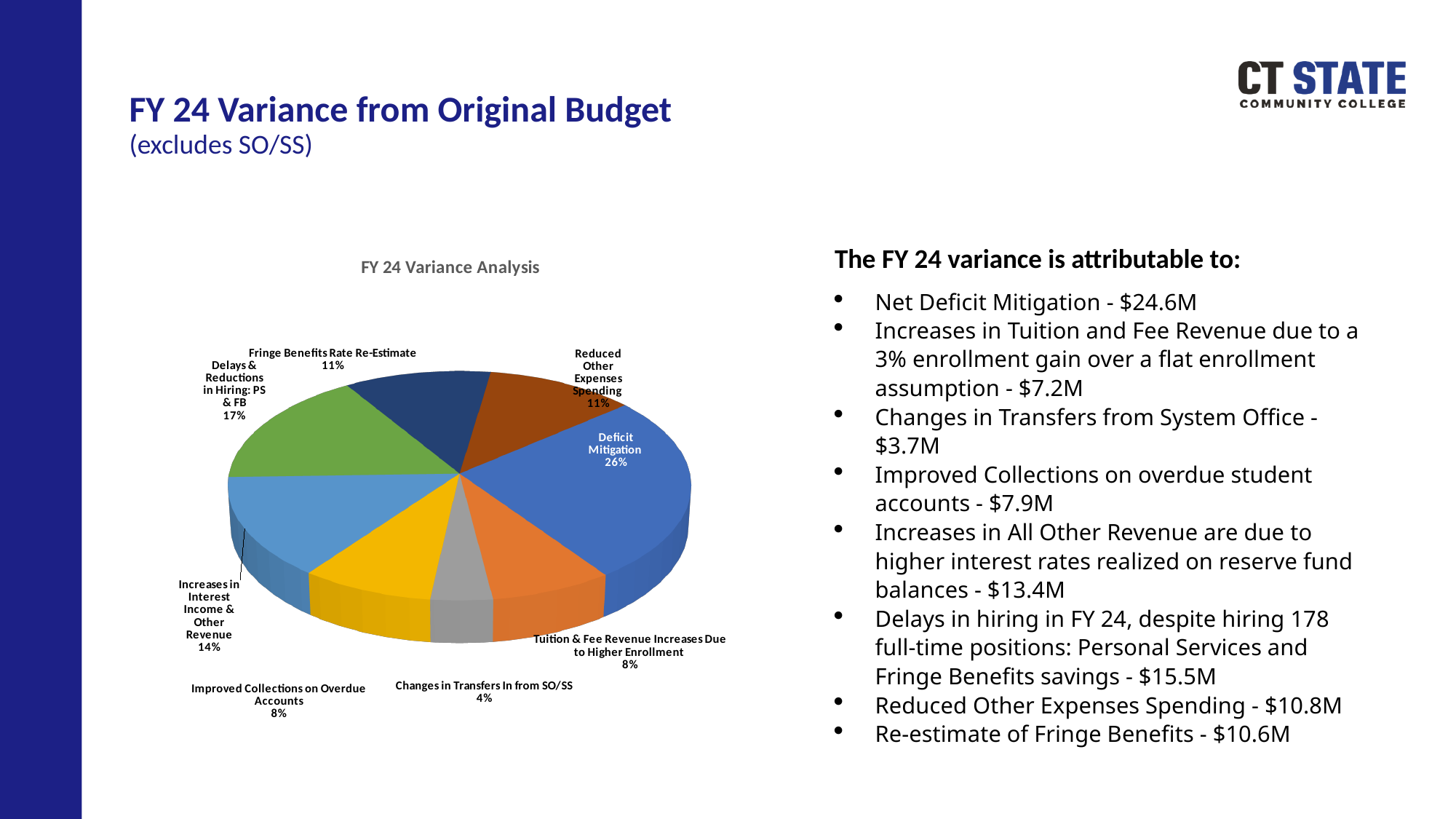
What is the difference in percentage points between Deficit Mitigation and Delays & Reductions in Hiring: PS & FB? 9 What type of chart is shown on the slide? pie chart Which slice is the smallest in the pie chart? Changes in Transfers In from SO/SS How many slices does the pie chart have? 8 What percentage is shown for Delays & Reductions in Hiring: PS & FB? 17% What share of the pie is Deficit Mitigation? 26% Which slice is the largest in the pie chart? Deficit Mitigation What percentage is shown for Increases in Interest Income & Other Revenue? 14% What percentage is shown for Changes in Transfers In from SO/SS? 4% Which is larger, Increases in Interest Income & Other Revenue or Fringe Benefits Rate Re-Estimate? Increases in Interest Income & Other Revenue What percentage is shown for Reduced Other Expenses Spending? 11% What is the title of the chart? FY 24 Variance Analysis